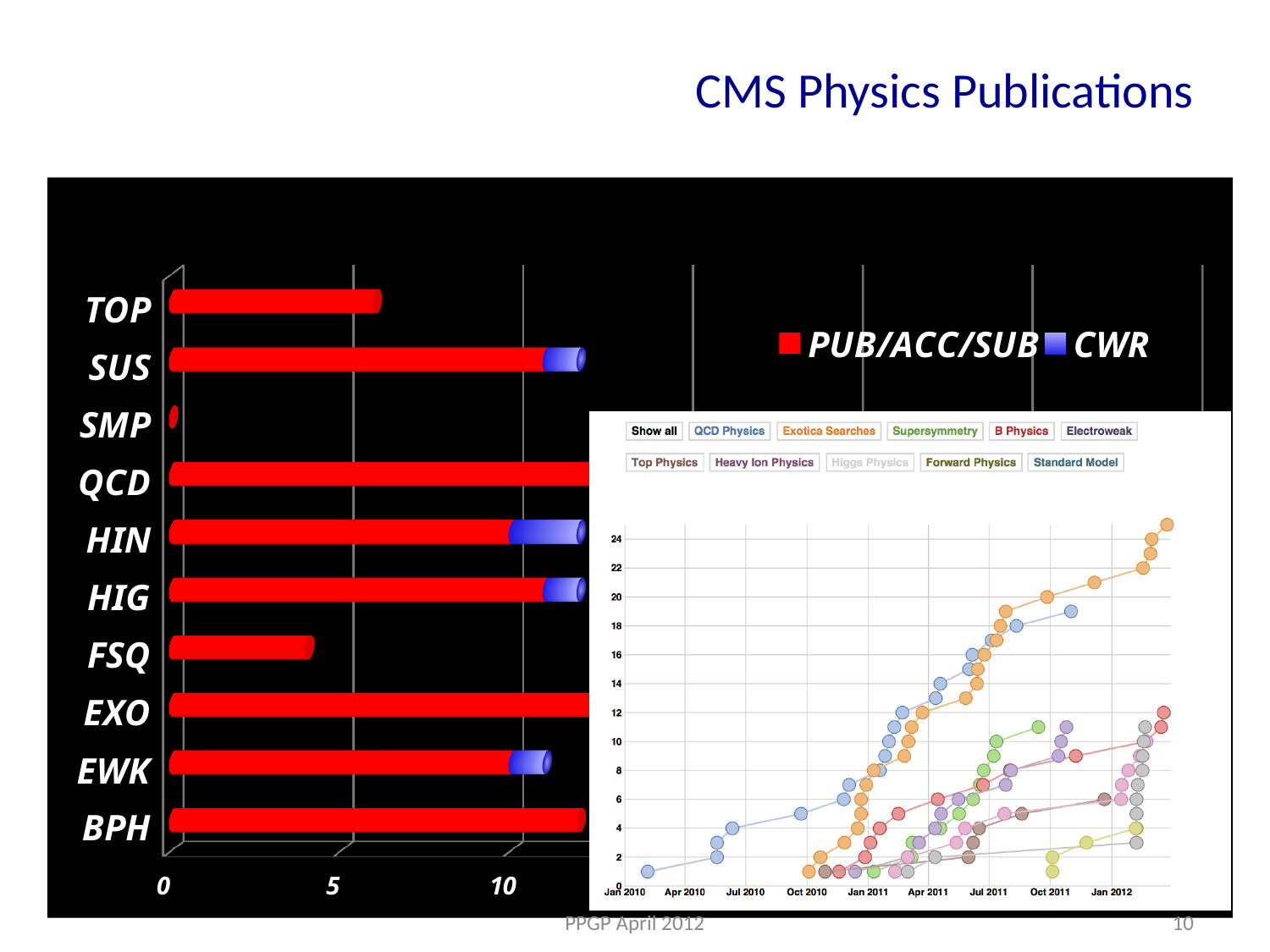
On the bar chart, is the total for HIN greater or less than 10? greater On the bar chart, is the value for TOP greater or less than 10? less On the bar chart, which is larger, the value for TOP or the value for FSQ? TOP On the bar chart, which colour represents the CWR series in the legend? blue On the bar chart, is the total for SUS greater or less than 10? greater On the bar chart, which physics group has the lowest total? SMP On the bar chart, what kind of chart is used to show the publications by physics group? bar chart On the bar chart, how many series does the legend list? 2 On the line chart in the lower right, what is the first date label on the x axis? Jan 2010 On the bar chart, how many physics groups (categories) are listed on the vertical axis? 10